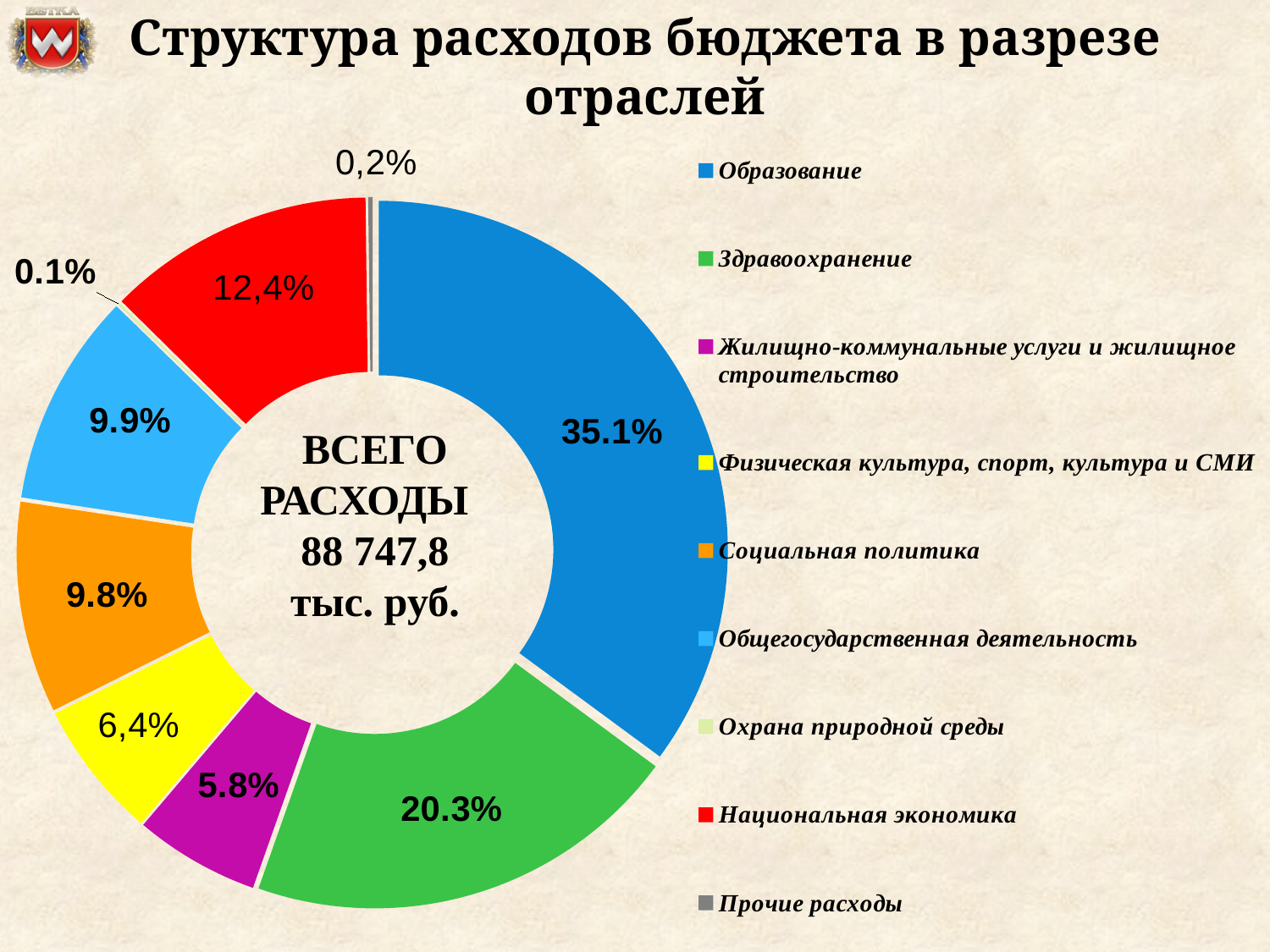
Which sector has the smallest share of budget expenditure? Охрана природной среды Which sector has the largest share of budget expenditure? Образование Which has a larger share: Физическая культура, спорт, культура и СМИ or Жилищно-коммунальные услуги и жилищное строительство? Физическая культура, спорт, культура и СМИ How many sectors are listed in the chart legend? 9 What percentage is shown for Социальная политика? 9.8% By how many percentage points does the share of Образование exceed the share of Здравоохранение? 14.8 percentage points What percentage is shown for Жилищно-коммунальные услуги и жилищное строительство? 5.8% What type of chart is shown on the slide? Doughnut (pie) chart What share of budget expenditure goes to Образование? 35.1% What percentage is shown for Национальная экономика? 12,4% What share of budget expenditure goes to Здравоохранение? 20.3% What total expenditure amount is shown in the centre of the chart? 88 747,8 тыс. руб.